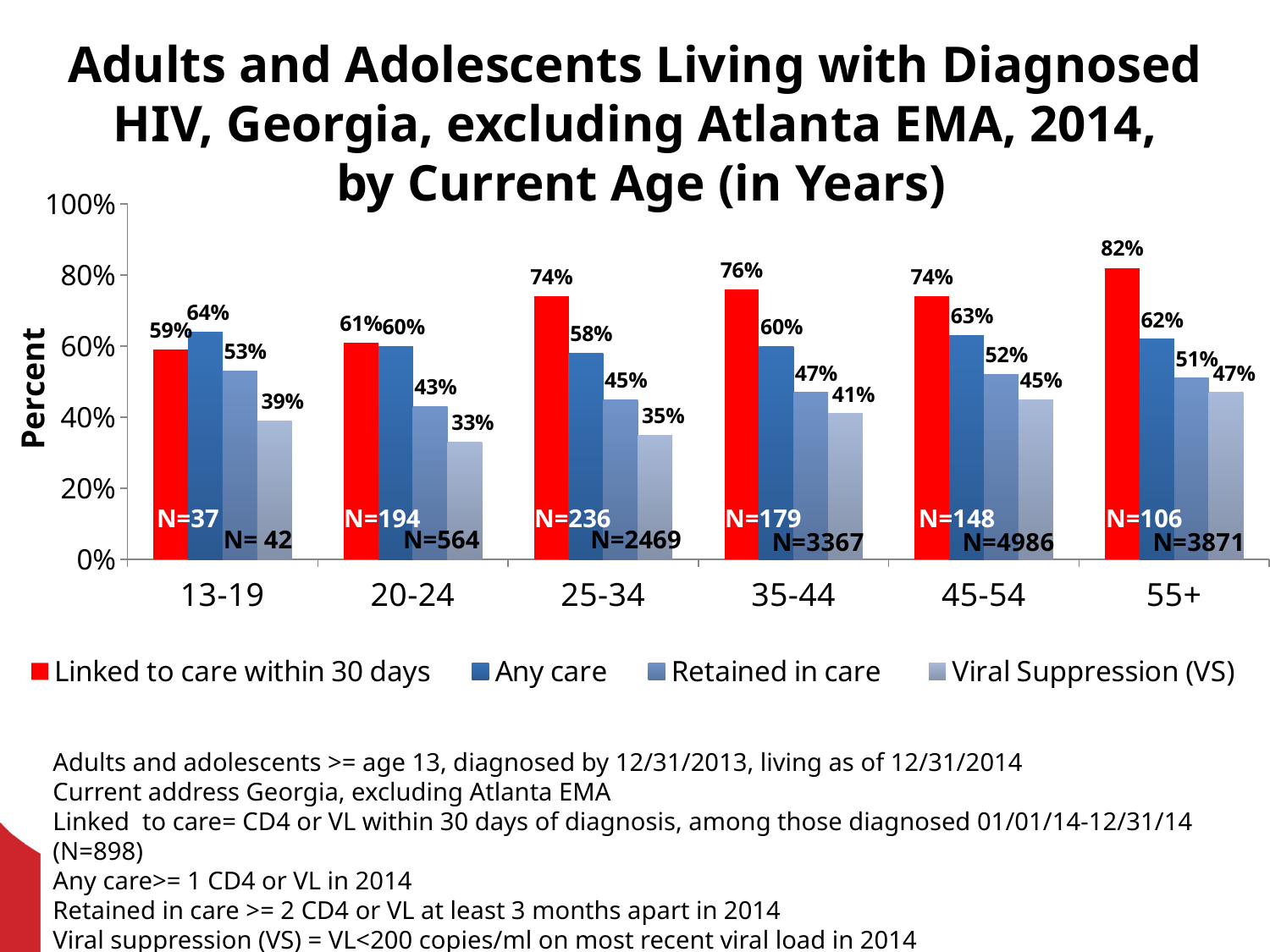
How many age groups are shown on the x axis? 6 What is the Viral Suppression (VS) value for the 13-19 age group? 39% What kind of chart is shown on the slide? Bar chart Which age group has the highest Linked to care within 30 days value? 55+ What is the label of the y axis? Percent What is the Retained in care value for the 35-44 age group? 47% Which age group has the lowest Viral Suppression (VS) value? 20-24 What is the difference between the Any care value and the Viral Suppression (VS) value for the 25-34 age group? 23% What is the Linked to care within 30 days value for the 55+ age group? 82% How many series does the legend list? 4 Does the Any care value rise or fall from the 13-19 age group to the 20-24 age group? Fall Which is larger for the 13-19 age group: Linked to care within 30 days or Any care? Any care